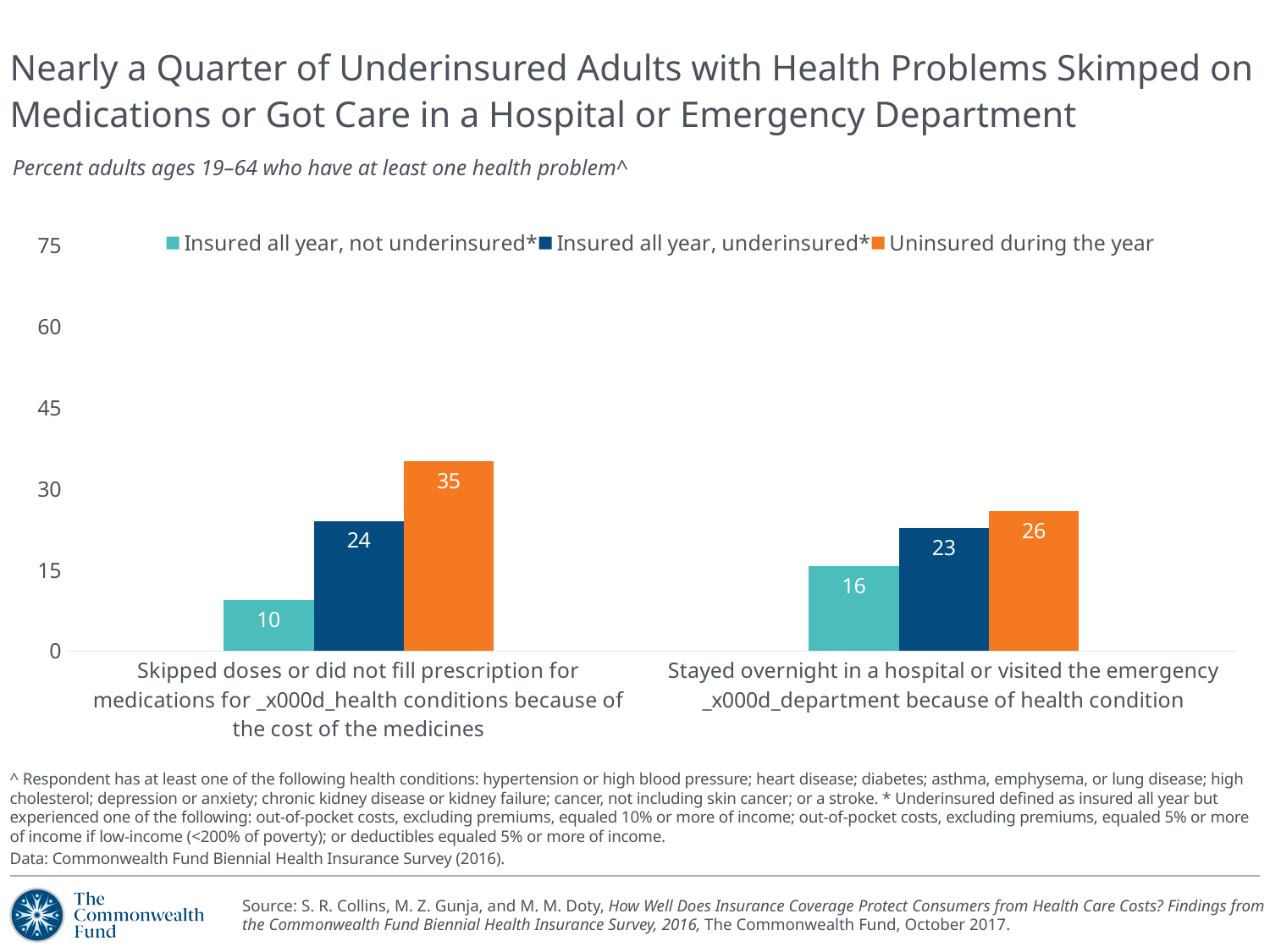
Is the value for 'Uninsured during the year' in the 'Skipped doses or did not fill prescription' category greater or less than 30? greater How many categories are shown on the x axis? 2 How many series does the legend list? 3 What is the value for 'Uninsured during the year' in the 'Stayed overnight in a hospital or visited the emergency department' category? 26 Which series has the highest value in the 'Skipped doses or did not fill prescription' category? Uninsured during the year What is the value for 'Insured all year, underinsured*' in the 'Skipped doses or did not fill prescription' category? 24 Which is larger: the 'Insured all year, underinsured*' value for skipping doses or for staying overnight in a hospital or visiting the emergency department? Skipped doses or did not fill prescription Which series has the lowest value in the 'Stayed overnight in a hospital or visited the emergency department' category? Insured all year, not underinsured* What is the difference between the 'Uninsured during the year' and 'Insured all year, not underinsured*' values in the 'Skipped doses or did not fill prescription' category? 25 What is the highest value shown on the y axis? 75 What is the value for 'Insured all year, not underinsured*' in the 'Stayed overnight in a hospital or visited the emergency department' category? 16 What kind of chart is shown on the slide? Bar chart